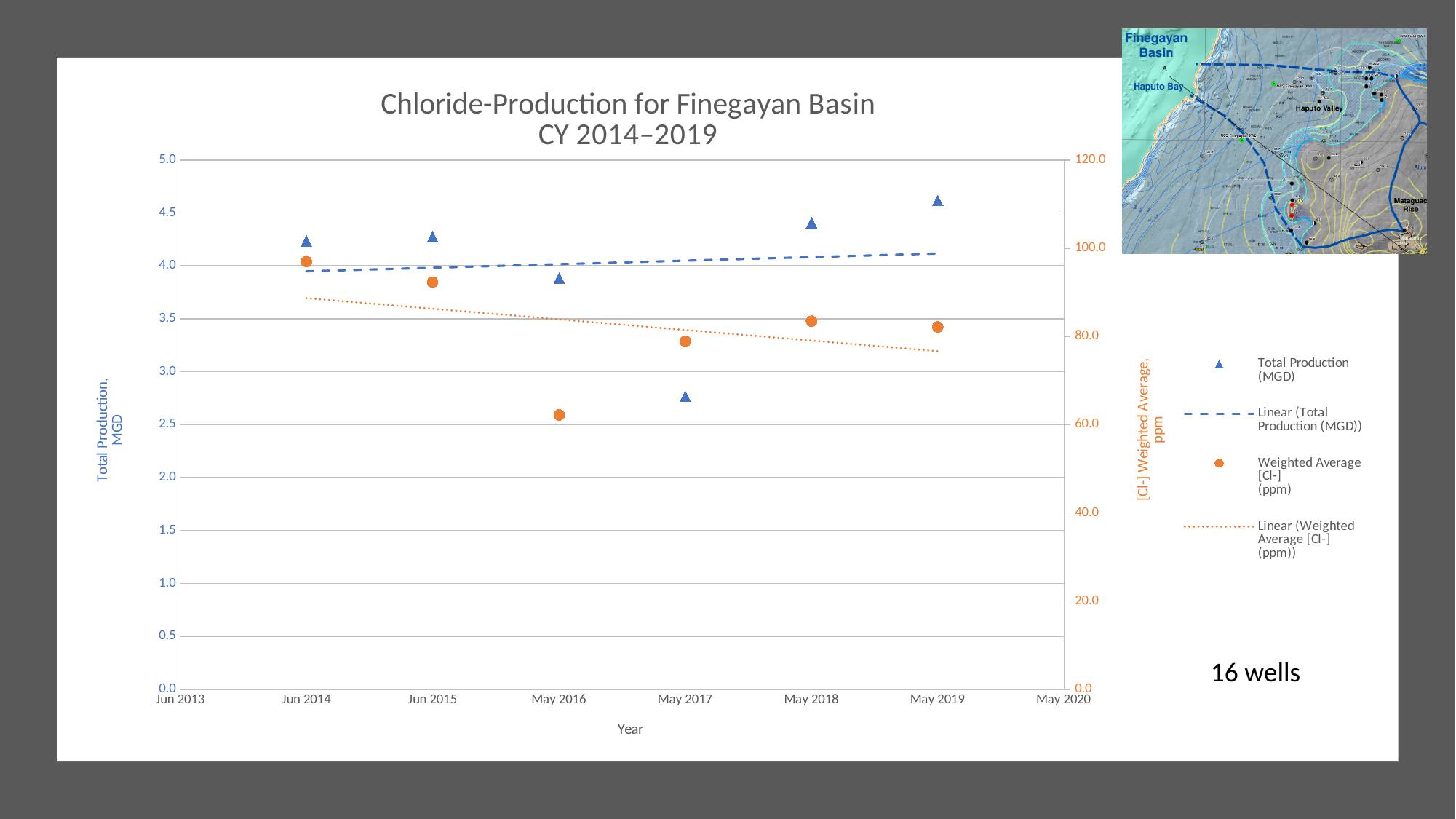
Is the Total Production (MGD) value for May 2017 greater or less than 3.0? less Which is larger, the Total Production (MGD) value for Jun 2015 or for May 2016? Jun 2015 What kind of chart is shown on the slide? scatter chart How many entries does the chart legend list? 4 How many Total Production (MGD) data points are plotted on the chart? 6 In which year is the Weighted Average [Cl-] (ppm) value the highest? Jun 2014 In which year is the Total Production (MGD) value the lowest? May 2017 What is the title of the chart? Chloride-Production for Finegayan Basin CY 2014–2019 Is the Weighted Average [Cl-] (ppm) value for Jun 2014 greater or less than 80.0? greater In which year is the Weighted Average [Cl-] (ppm) value the lowest? May 2016 Does the dotted linear trendline for Weighted Average [Cl-] (ppm) rise or fall from left to right? fall In which year is the Total Production (MGD) value the highest? May 2019